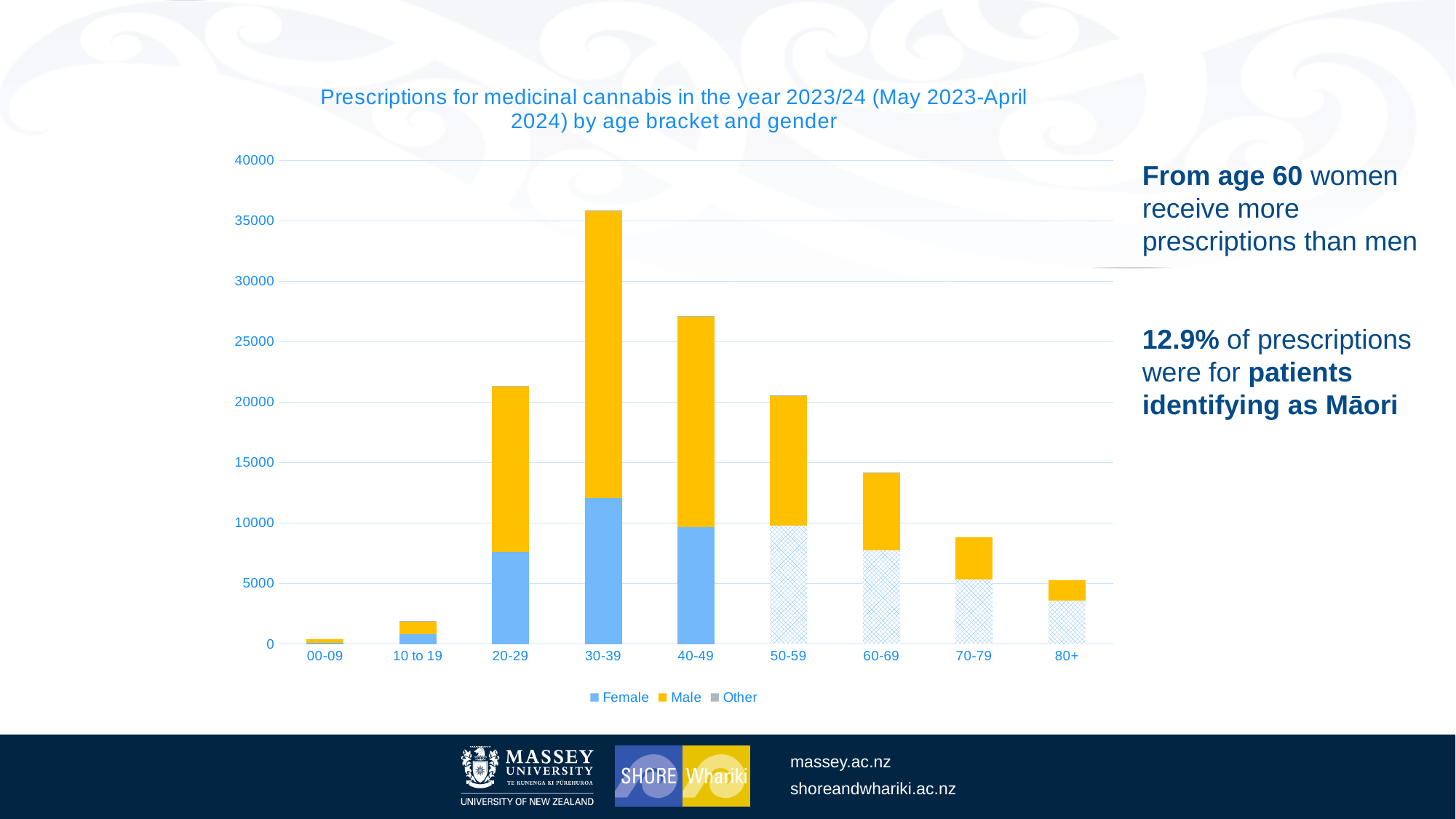
Which age bracket has the highest total number of prescriptions? 30-39 Is the total value for the 60-69 bracket greater or less than 15000? less What kind of chart is shown on the slide? Stacked bar chart Which has a larger total, the 40-49 bracket or the 50-59 bracket? 40-49 Is the total value for the 70-79 bracket greater or less than 10000? less Is the total value for the 30-39 bracket greater or less than 30000? greater Which age bracket has the lowest total number of prescriptions? 00-09 Do the total prescriptions rise or fall across the age brackets from 30-39 to 80+? fall Which series is shown in yellow in the legend? Male How many series does the legend list? 3 How many age brackets are shown on the x axis? 9